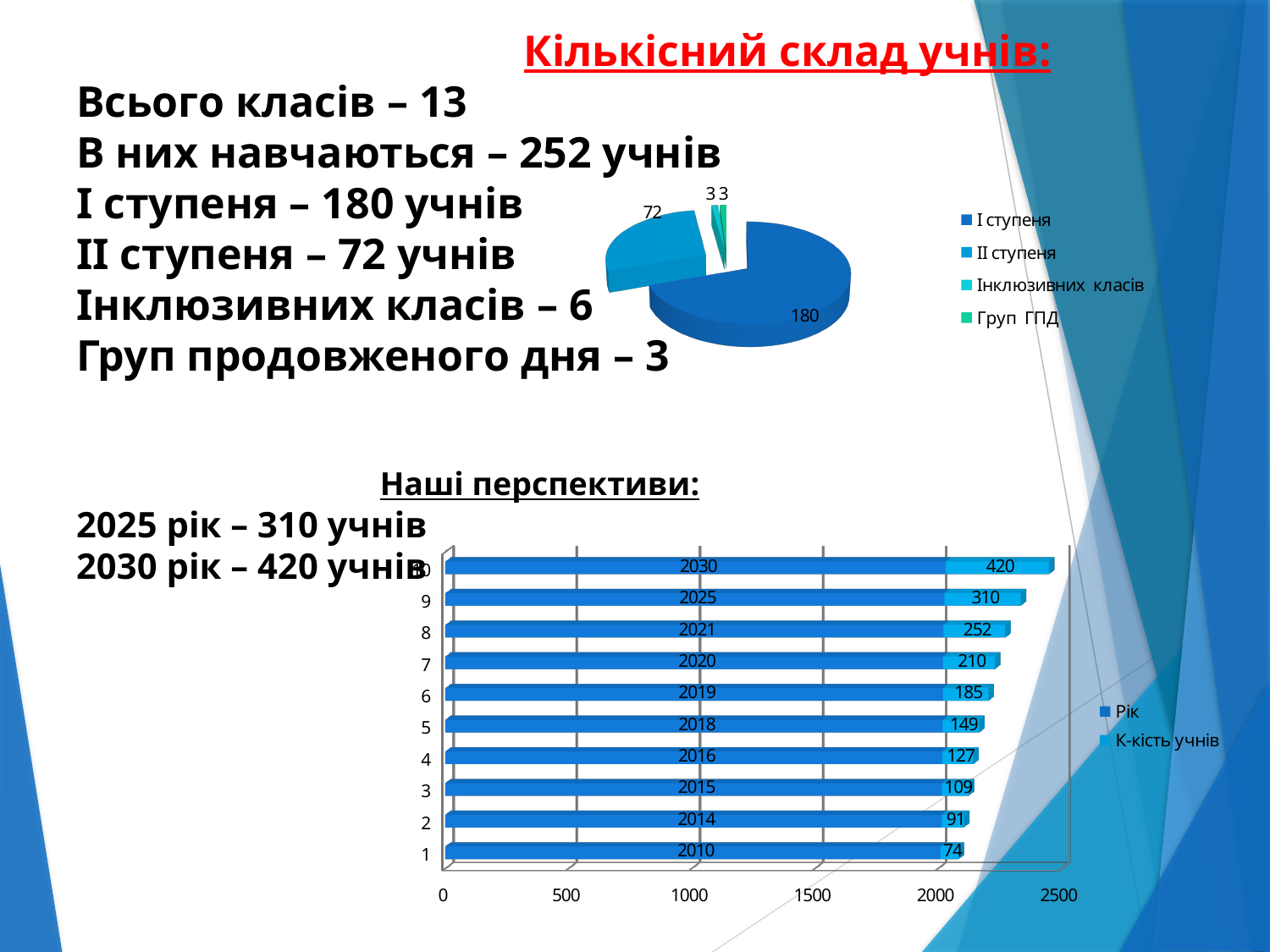
In the pie chart at the top of the slide, what is the difference between the I ступеня value and the II ступеня value? 108 In the bar chart at the bottom of the slide, what is the К-кість учнів value for the bar labelled 2010? 74 What kind of chart is the chart at the bottom of the slide? Bar chart In the pie chart at the top of the slide, which category has the largest slice? I ступеня In the pie chart at the top of the slide, what value is shown for the I ступеня slice? 180 In the bar chart at the bottom of the slide, what is the К-кість учнів value for the bar labelled 2021? 252 In the bar chart at the bottom of the slide, do the К-кість учнів values rise or fall from category 1 to category 10? Rise In the bar chart at the bottom of the slide, how many bars (categories) are plotted? 10 In the bar chart at the bottom of the slide, how many series does the legend list? 2 In the pie chart at the top of the slide, how many entries does the legend list? 4 In the pie chart at the top of the slide, what value is shown for the II ступеня slice? 72 In the bar chart at the bottom of the slide, what is the total of the stacked bar for category 10 (2030 + 420)? 2450